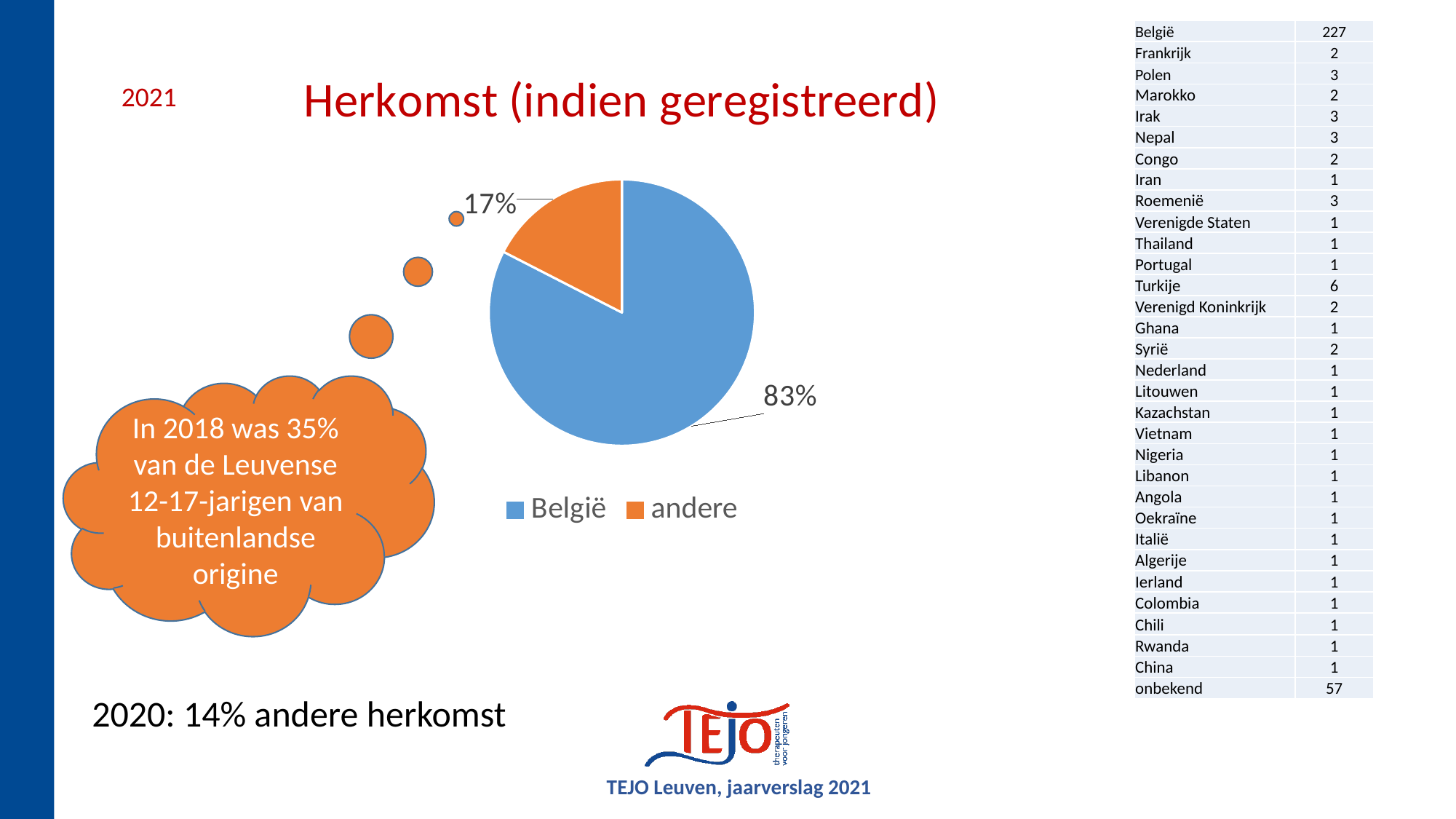
What is the title of the chart? Herkomst (indien geregistreerd) Which slice of the pie is the largest? België What is the difference in percentage points between the België slice and the andere slice? 66 What share of the pie does België represent? 83% How many slices does the pie chart have? 2 Which slice of the pie is the smallest? andere What share of the pie does andere represent? 17% What colour is the andere slice in the pie chart? orange How many entries does the legend list? 2 What kind of chart is shown on the slide? pie chart Which is larger, the België slice or the andere slice? België